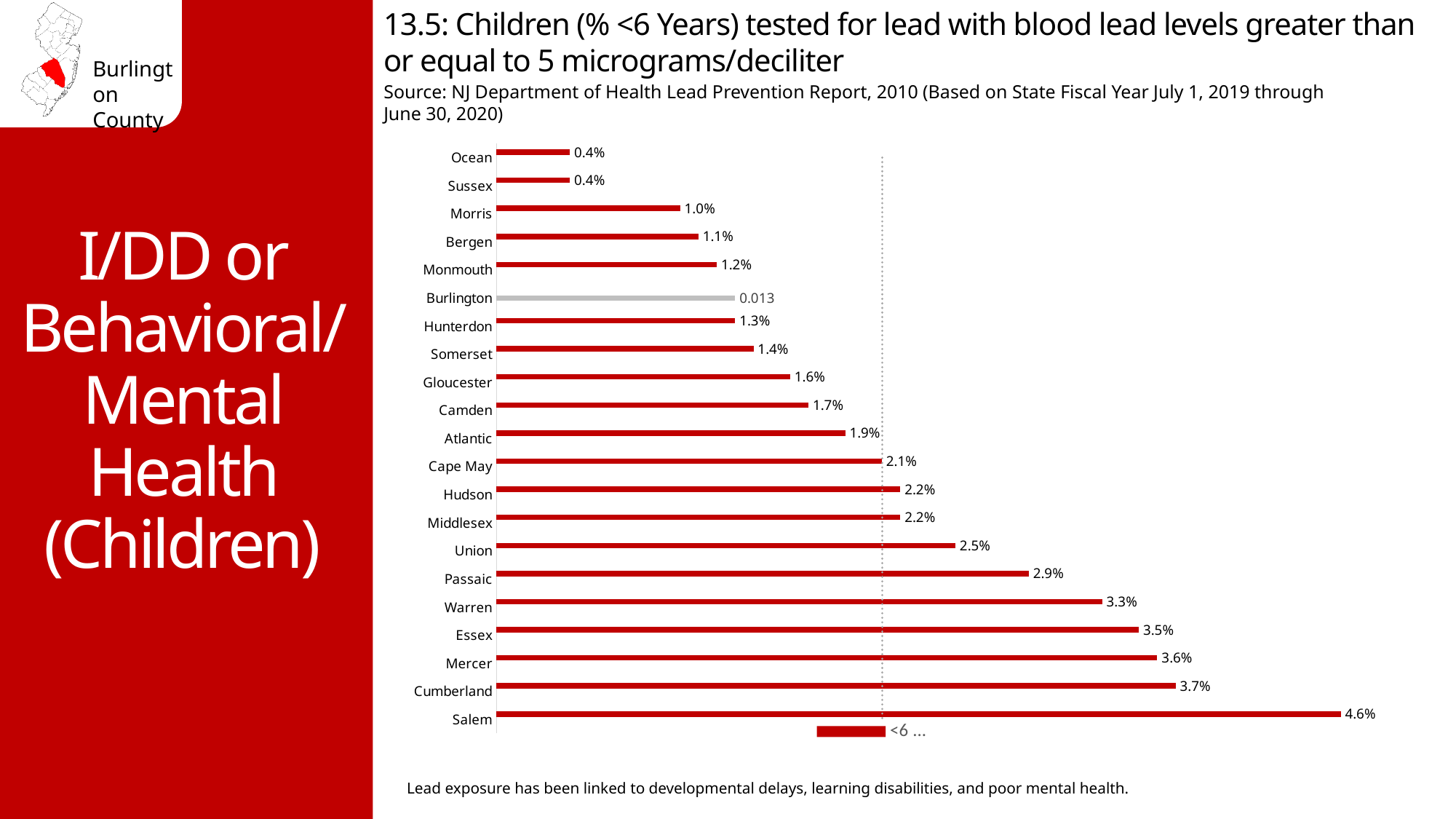
What is the value shown for Salem? 4.6% What is the difference between the values for Salem and Cumberland? 0.9% What is the value shown for Passaic? 2.9% What is the value shown for Camden? 1.7% How many counties are listed in the chart? 21 What value is printed next to the Burlington bar? 0.013 Which has a larger value, Morris or Monmouth? Monmouth What is the difference between the values for Passaic and Union? 0.4% What colour is the Burlington bar, compared with the other bars? gray (the others are red) Which county has the highest value in the chart? Salem Which has a larger value, Warren or Essex? Essex What type of chart is shown on the slide? bar chart